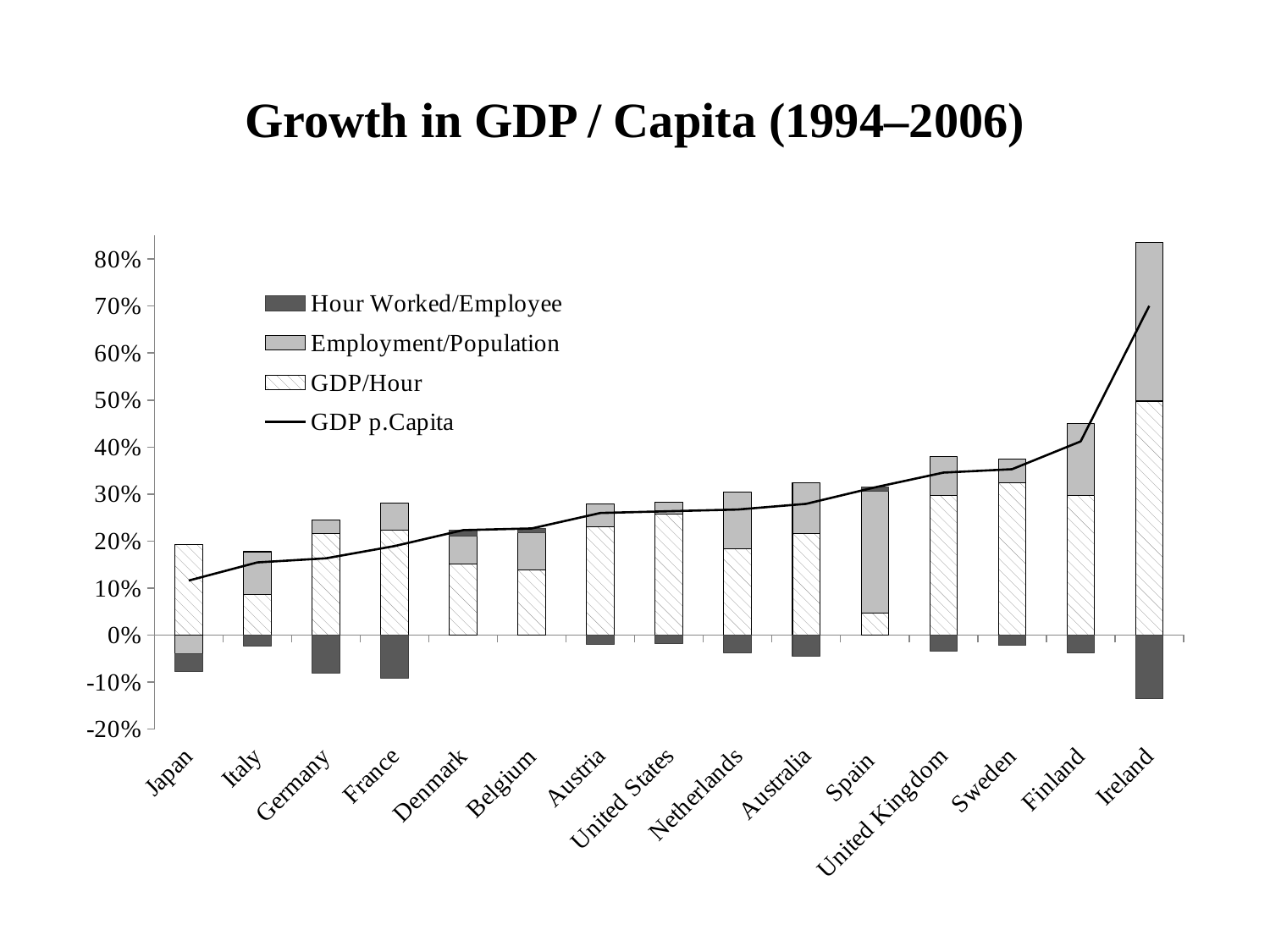
Is the GDP p.Capita value for Japan greater or less than 20%? less What is the title of the chart? Growth in GDP / Capita (1994–2006) Does the GDP p.Capita line generally rise or fall from Japan to Ireland? rise What kind of chart is this? Stacked bar chart with a line Which has the higher GDP p.Capita value, Finland or Sweden? Finland Is the GDP p.Capita value for Ireland greater or less than 60%? greater Which country has the lowest GDP p.Capita value on the line? Japan Which country has the highest GDP p.Capita value on the line? Ireland How many countries are shown on the x axis? 15 Which country has the most negative Hour Worked/Employee segment? Ireland Which country has the largest GDP/Hour segment? Ireland How many series does the legend list? 4